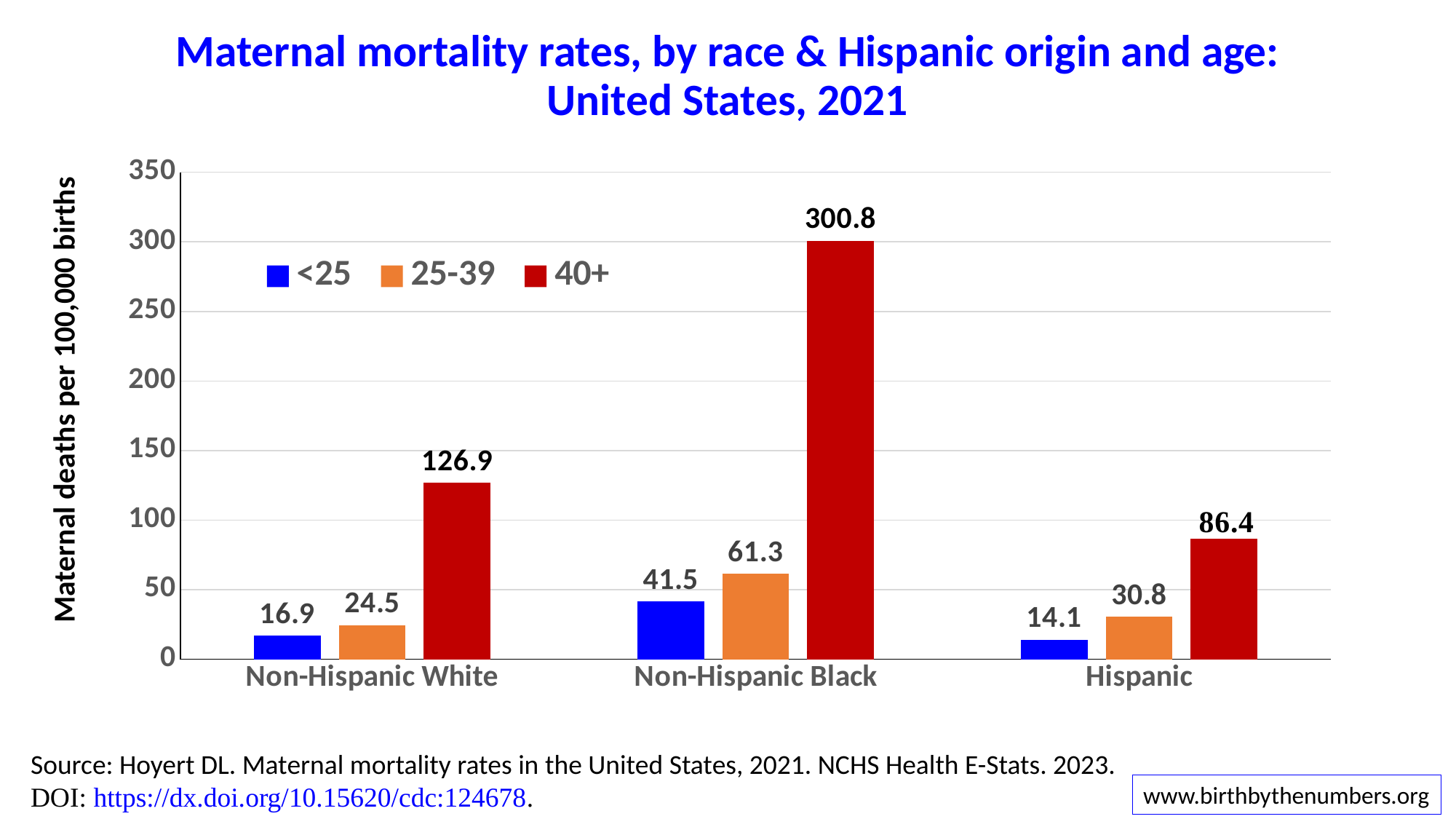
What is the maternal mortality rate for Non-Hispanic White women aged 25-39? 24.5 Which race/Hispanic origin group has the lowest maternal mortality rate in the <25 age group? Hispanic What is the difference between the 40+ maternal mortality rates for Non-Hispanic Black and Non-Hispanic White women? 173.9 How many race/Hispanic origin groups are shown on the x axis? 3 Which race/Hispanic origin group has the highest maternal mortality rate in the 40+ age group? Non-Hispanic Black How many age groups does the legend list? 3 What is the difference between the 25-39 rates for Non-Hispanic Black and Hispanic women? 30.5 Is the 40+ maternal mortality rate for Non-Hispanic Black women greater or less than 250? greater What is the maternal mortality rate for Hispanic women under 25? 14.1 What type of chart is shown on the slide? Bar chart Which is larger: the 40+ rate for Hispanic women or the 40+ rate for Non-Hispanic White women? Non-Hispanic White What is the maternal mortality rate for Non-Hispanic Black women aged 40+? 300.8